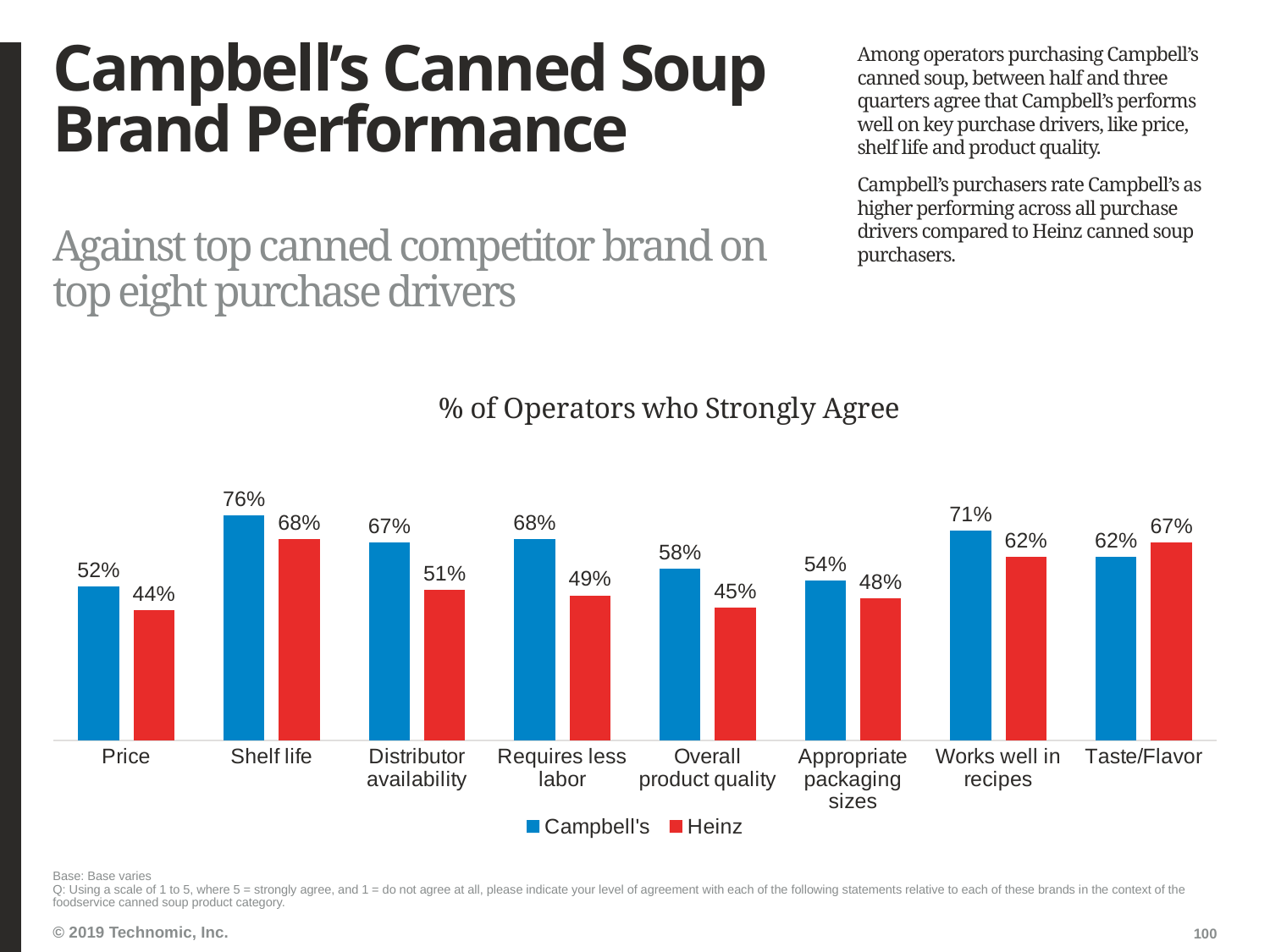
What is the Heinz value for Shelf life? 68% Which purchase driver has the lowest Heinz value? Price What kind of chart is shown on the slide? Bar chart Which is larger for Taste/Flavor, the Campbell's value or the Heinz value? Heinz How many purchase drivers are shown on the x axis? 8 What is the title of the chart? % of Operators who Strongly Agree What is the Heinz value for Overall product quality? 45% What is the Campbell's value for Works well in recipes? 71% How many series does the legend list? 2 Which purchase driver has the highest Campbell's value? Shelf life What is the difference between the Campbell's and Heinz values for Requires less labor? 19 percentage points What percentage of operators strongly agree that Campbell's performs well on Price? 52%